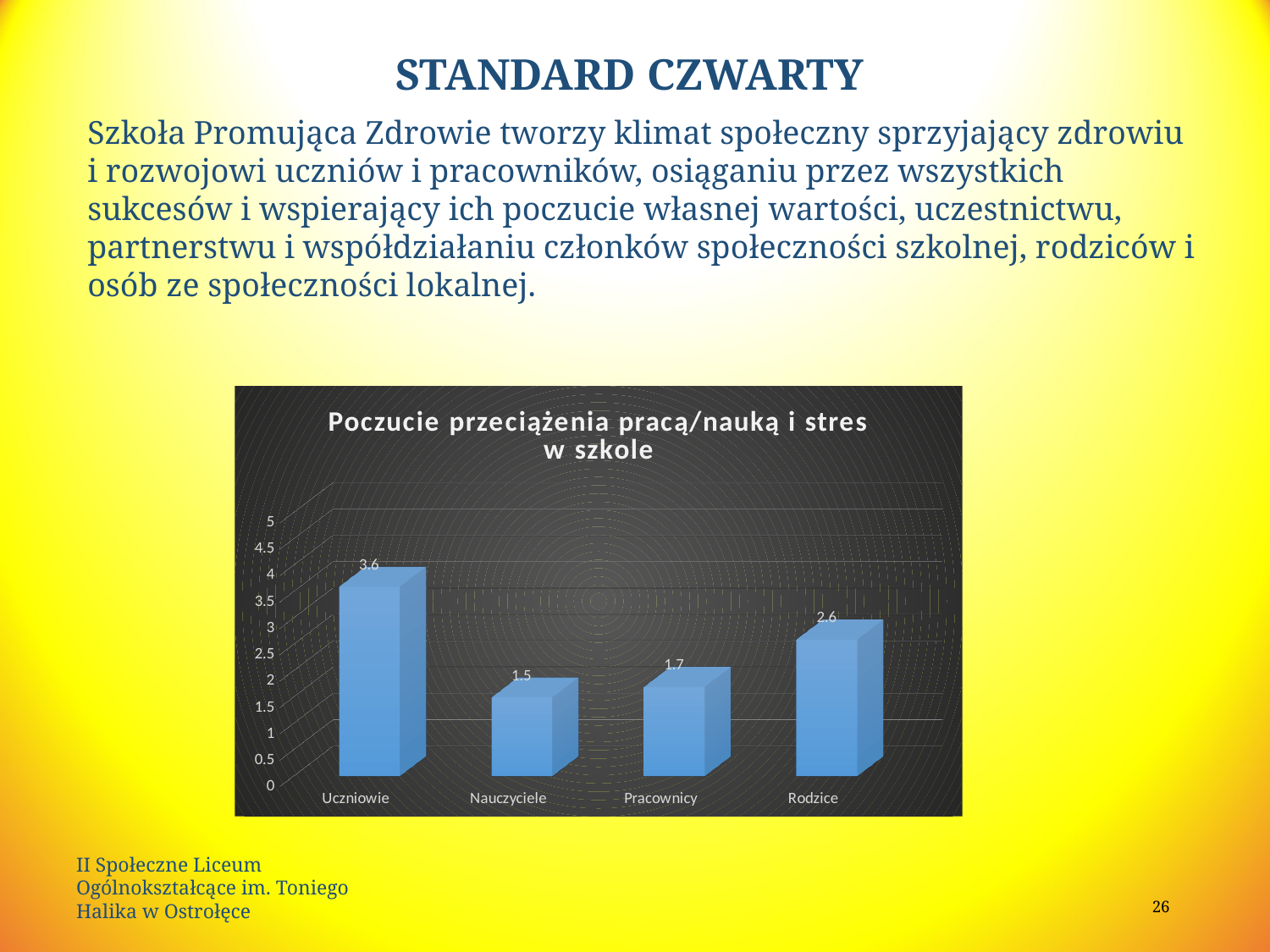
What is the value for Nauczyciele? 1.5 Which category has the highest value? Uczniowie What is the difference between the values for Uczniowie and Rodzice? 1 Which category has the lowest value? Nauczyciele Is the value for Uczniowie greater or less than 3? greater What is the difference between the values for Pracownicy and Nauczyciele? 0.2 Which is larger, the value for Rodzice or the value for Pracownicy? Rodzice What is the value for Pracownicy? 1.7 What is the value for Rodzice? 2.6 How many categories are shown on the chart? 4 What is the value for Uczniowie? 3.6 What is the title of the chart? Poczucie przeciążenia pracą/nauką i stres w szkole